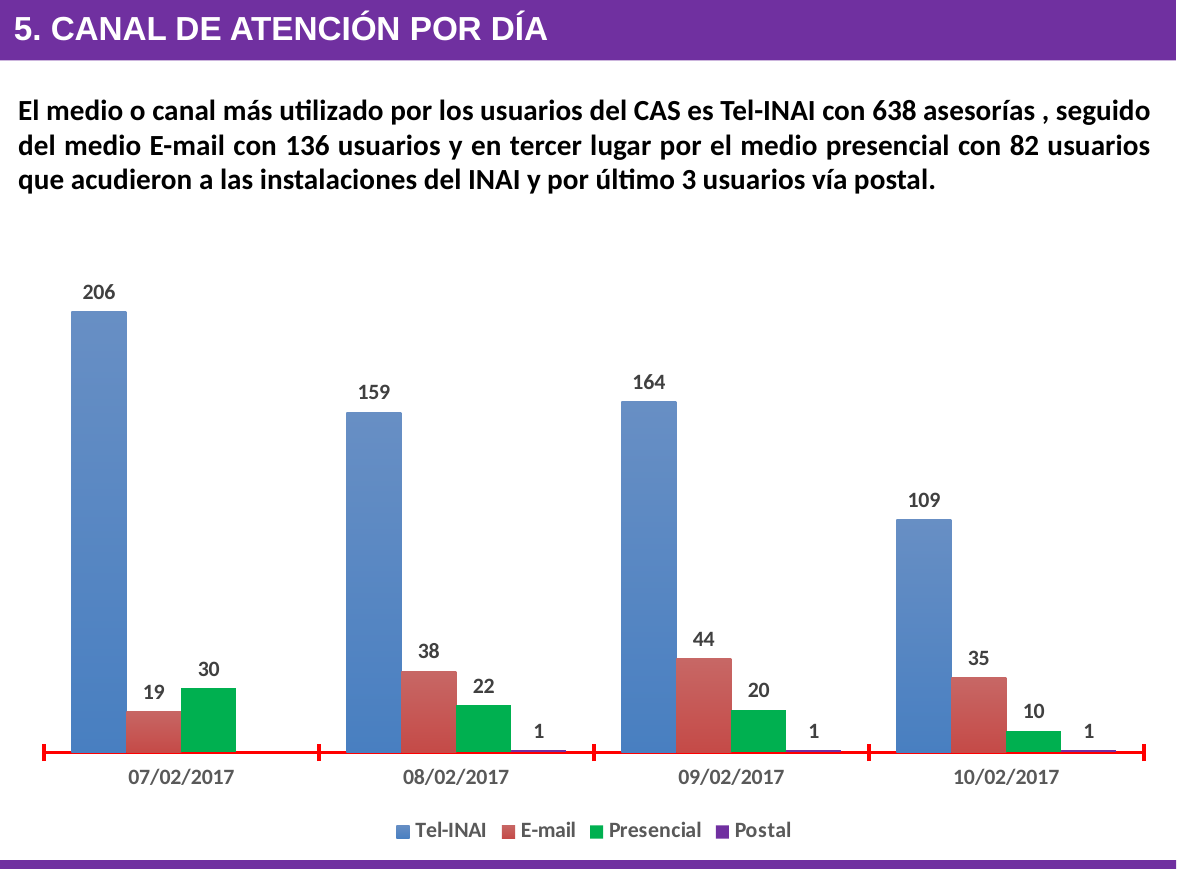
What is the Tel-INAI value for 07/02/2017? 206 How many dates are shown on the x axis? 4 What is the Postal value for 08/02/2017? 1 What kind of chart is shown on the slide? Bar chart On which date is the Tel-INAI value highest? 07/02/2017 Which series is shown in green in the legend? Presencial On which date is the E-mail value lowest? 07/02/2017 How many series does the legend list? 4 What is the difference between the Tel-INAI values for 07/02/2017 and 10/02/2017? 97 Which is larger, the Presencial value for 07/02/2017 or the E-mail value for 07/02/2017? Presencial value for 07/02/2017 What is the E-mail value for 09/02/2017? 44 What is the Presencial value for 10/02/2017? 10